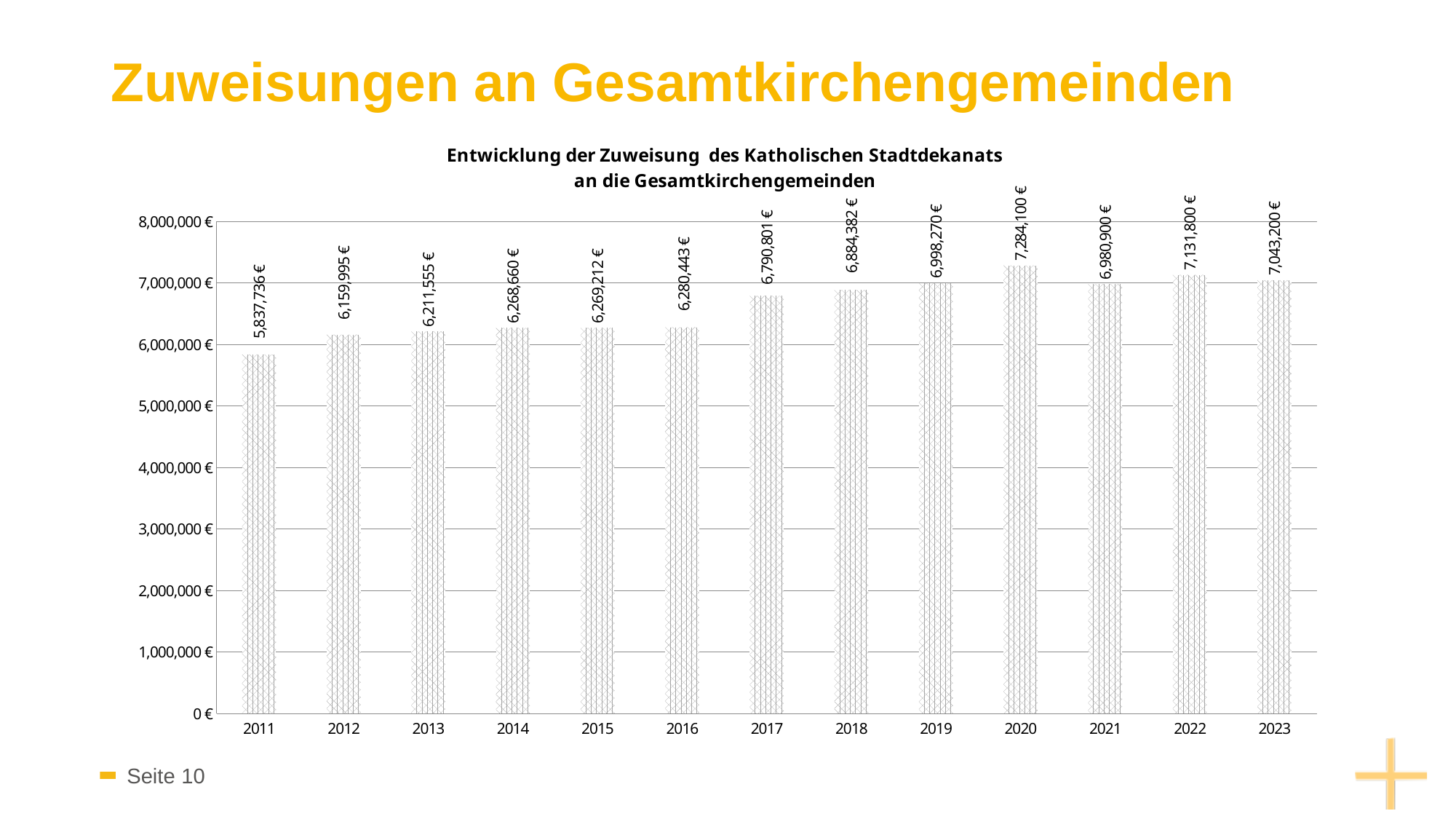
What is the difference between the values for 2022 and 2023? 88,600 € What is the value for 2011? 5,837,736 € What is the value for 2017? 6,790,801 € Is the value for 2016 greater or less than 7,000,000 €? less Which is larger, the value for 2022 or the value for 2021? 2022 What is the value for 2023? 7,043,200 € What kind of chart is shown on the slide? bar chart Which year has the highest value? 2020 How many years are shown on the x axis? 13 What is the difference between the values for 2020 and 2011? 1,446,364 € What is the value for 2020? 7,284,100 € Which year has the lowest value? 2011